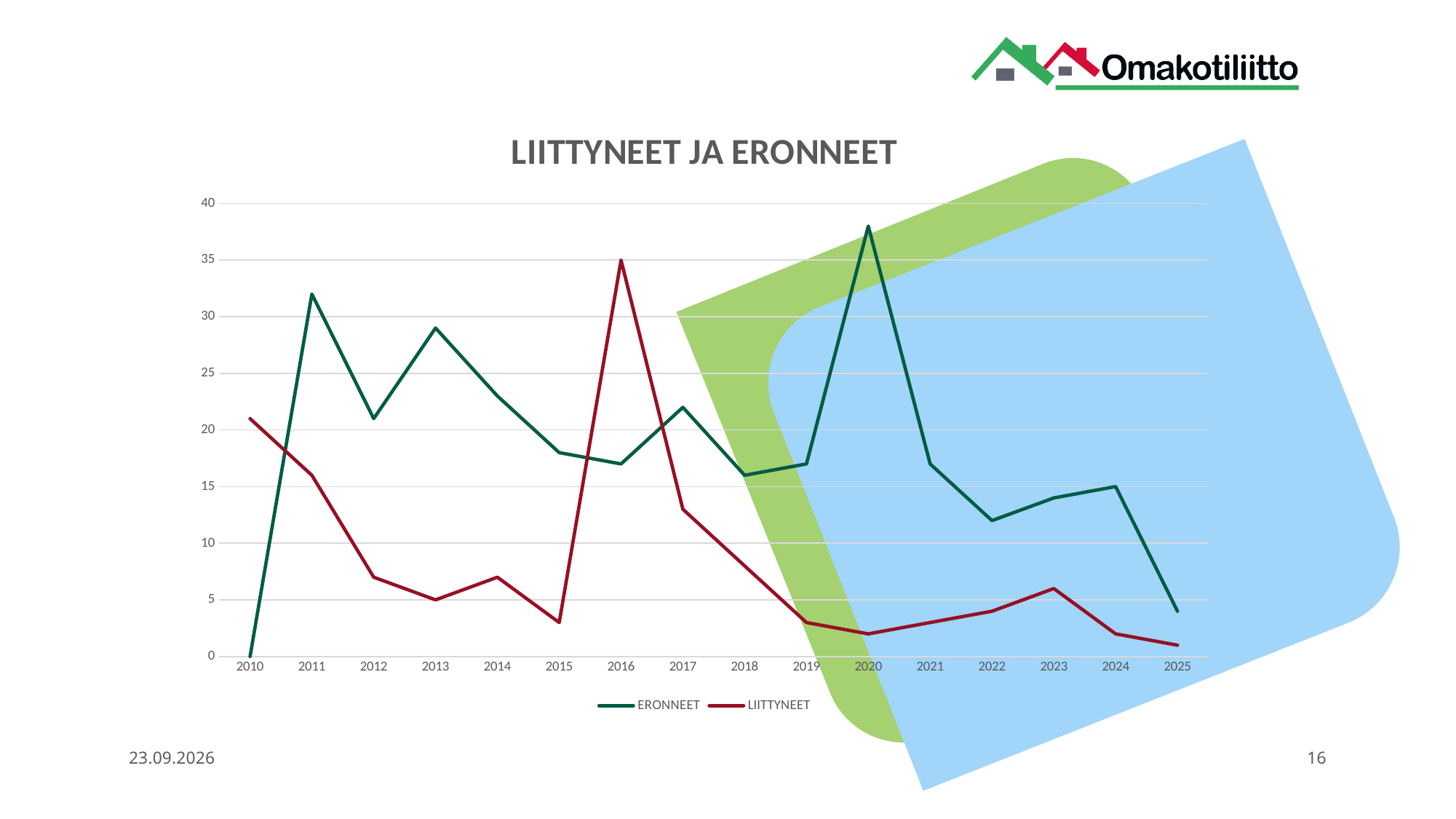
What is the value of ERONNEET in 2010? 0 In which year is the ERONNEET series at its lowest value? 2010 How many years are shown on the x axis? 16 What kind of chart is shown on the slide? line chart Does the ERONNEET series rise or fall from 2020 to 2022? fall Is the value for LIITTYNEET in 2025 greater or less than 5? less What is the title of the chart? LIITTYNEET JA ERONNEET Which series has the larger value in 2016, ERONNEET or LIITTYNEET? LIITTYNEET In which year does the LIITTYNEET series reach its highest value? 2016 How many series does the legend list? 2 In which year does the ERONNEET series reach its highest value? 2020 Is the value for ERONNEET in 2020 greater or less than 35? greater